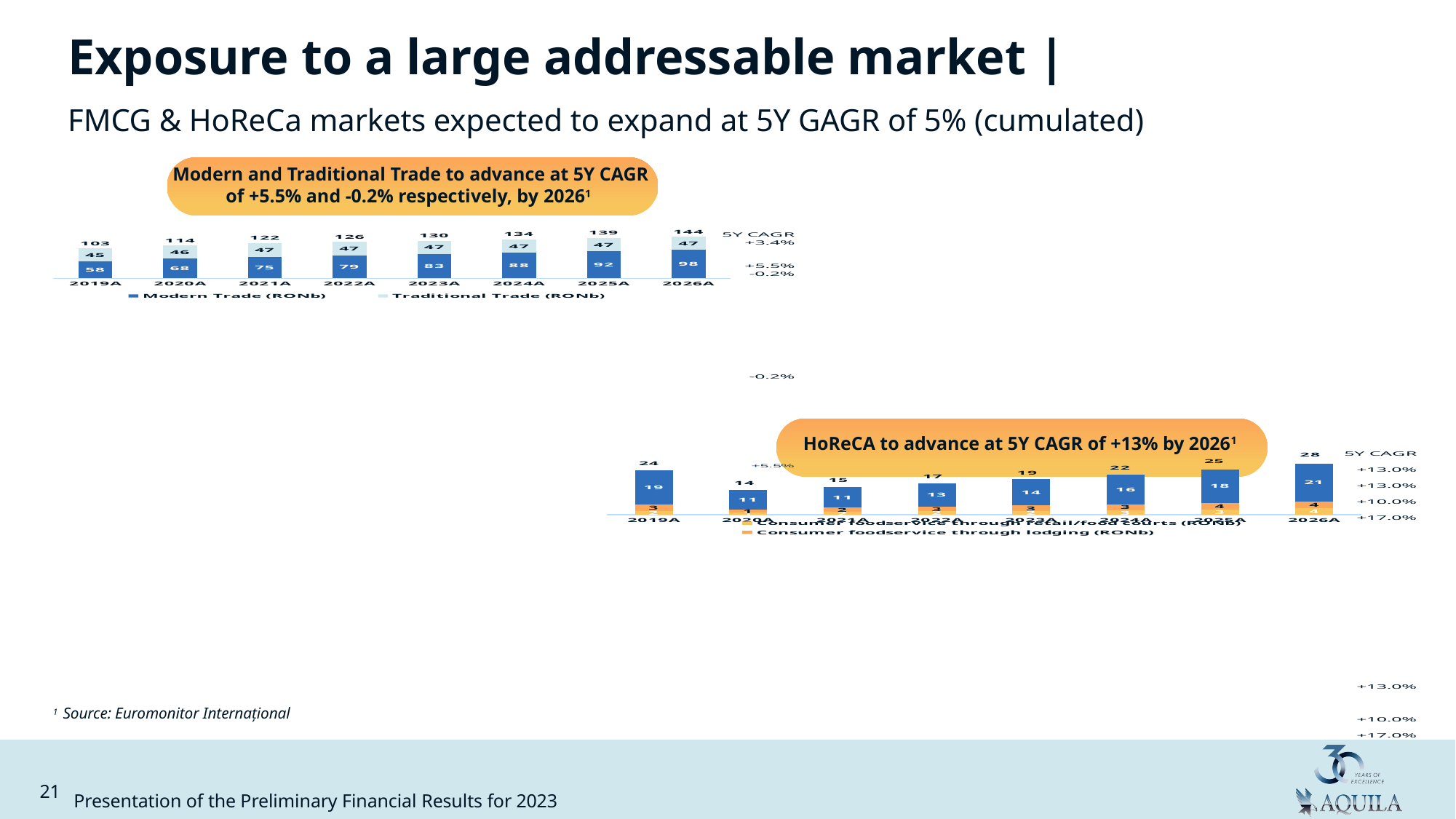
What kind of chart is the HoReCa chart (bottom right)? stacked bar chart In the HoReCa chart (bottom right), what is the Consumer foodservice through lodging value for 2025A? 4 In the Modern and Traditional Trade chart (top left), what is the difference between the Modern Trade values for 2026A and 2019A? 40 In the Modern and Traditional Trade chart (top left), which year has the highest total? 2026A In the HoReCa chart (bottom right), what is the total of the stacked bar for 2026A? 28 In the Modern and Traditional Trade chart (top left), how many years are shown on the x axis? 8 In the Modern and Traditional Trade chart (top left), what is the Traditional Trade value for 2019A? 45 In the HoReCa chart (bottom right), which year has the lowest total? 2020A In the Modern and Traditional Trade chart (top left), does the Modern Trade value rise or fall from 2019A to 2026A? rise In the Modern and Traditional Trade chart (top left), what is the total of the stacked bar for 2022A? 126 In the Modern and Traditional Trade chart (top left), what is the Modern Trade value for 2026A? 98 In the Modern and Traditional Trade chart (top left), how many series does the legend list? 2